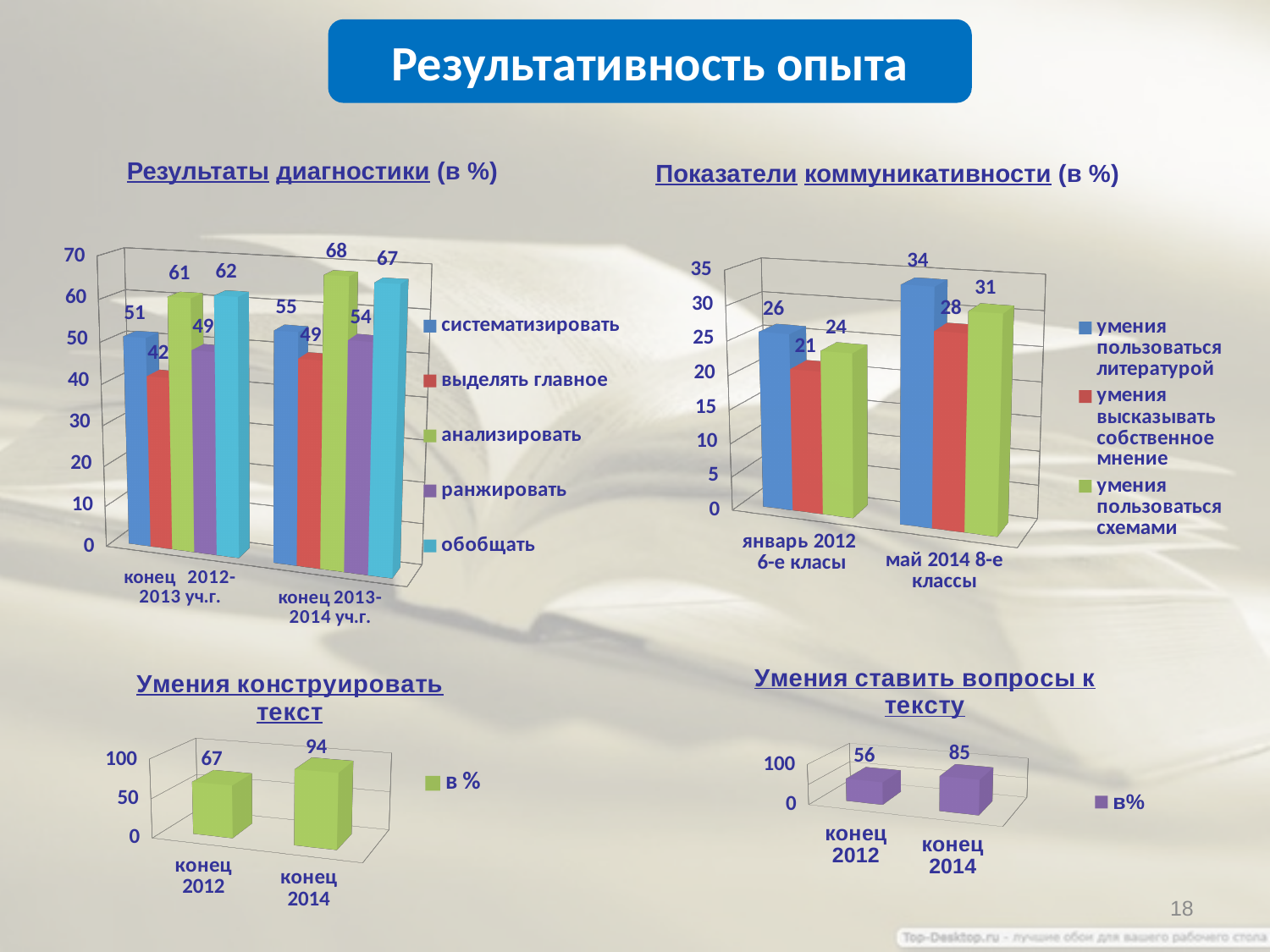
What kind of chart is 'Умения ставить вопросы к тексту'? bar chart In the chart 'Показатели коммуникативности (в %)', which series has the lowest value at 'январь 2012 6-е класы'? умения высказывать собственное мнение In the chart 'Результаты диагностики (в %)', what is the value for 'выделять главное' at 'конец 2012-2013 уч.г.'? 42 In the chart 'Результаты диагностики (в %)', which series has the lowest value at 'конец 2012-2013 уч.г.'? выделять главное In the chart 'Результаты диагностики (в %)', what is the difference between the 'систематизировать' values at 'конец 2013-2014 уч.г.' and 'конец 2012-2013 уч.г.'? 4 In the chart 'Умения ставить вопросы к тексту', what is the difference between the values for 'конец 2014' and 'конец 2012'? 29 In the chart 'Умения конструировать текст', what is the value for 'конец 2014'? 94 In the chart 'Показатели коммуникативности (в %)', what is the difference between the 'умения пользоваться схемами' values at 'май 2014 8-е классы' and 'январь 2012 6-е класы'? 7 In the chart 'Показатели коммуникативности (в %)', what is the value for 'умения пользоваться литературой' at 'май 2014 8-е классы'? 34 In the chart 'Показатели коммуникативности (в %)', how many categories are shown on the x axis? 2 In the chart 'Результаты диагностики (в %)', how many series does the legend list? 5 In the chart 'Результаты диагностики (в %)', what is the value for 'анализировать' at 'конец 2013-2014 уч.г.'? 68